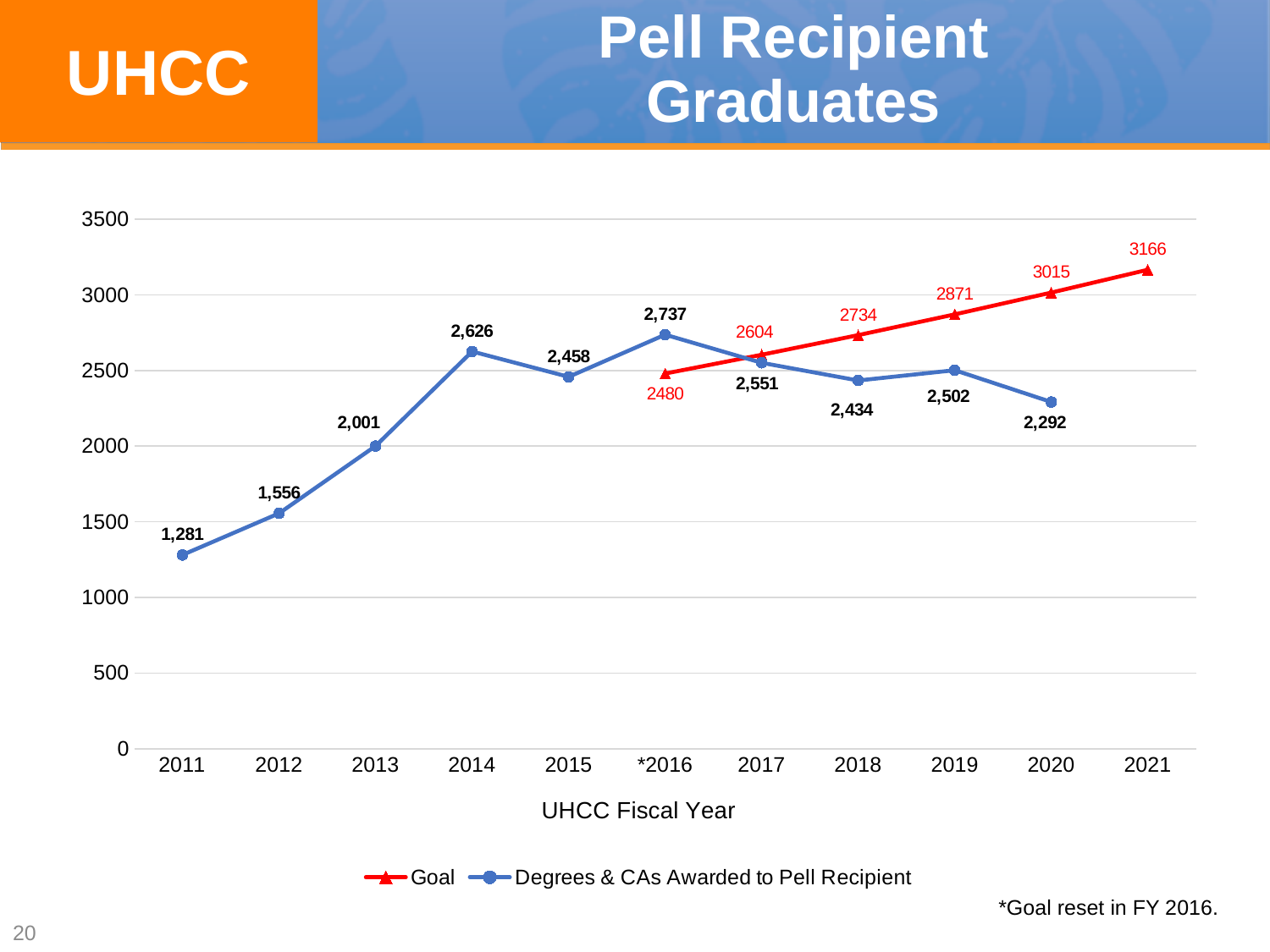
What is the value for Degrees & CAs Awarded to Pell Recipient in 2020? 2,292 What is the Goal value for 2021? 3166 Does the Goal series rise or fall from *2016 to 2021? Rise What is the x-axis title of the chart? UHCC Fiscal Year What is the value for Degrees & CAs Awarded to Pell Recipient in 2014? 2,626 How many series does the legend list? 2 How many years are shown on the x axis? 11 What kind of chart is shown on the slide? Line chart Which is larger in 2018, the Goal or the Degrees & CAs Awarded to Pell Recipient? Goal In which year is the Degrees & CAs Awarded to Pell Recipient series highest? *2016 In which year is the Degrees & CAs Awarded to Pell Recipient series lowest? 2011 What is the difference between the Goal and the Degrees & CAs Awarded to Pell Recipient in 2020? 723